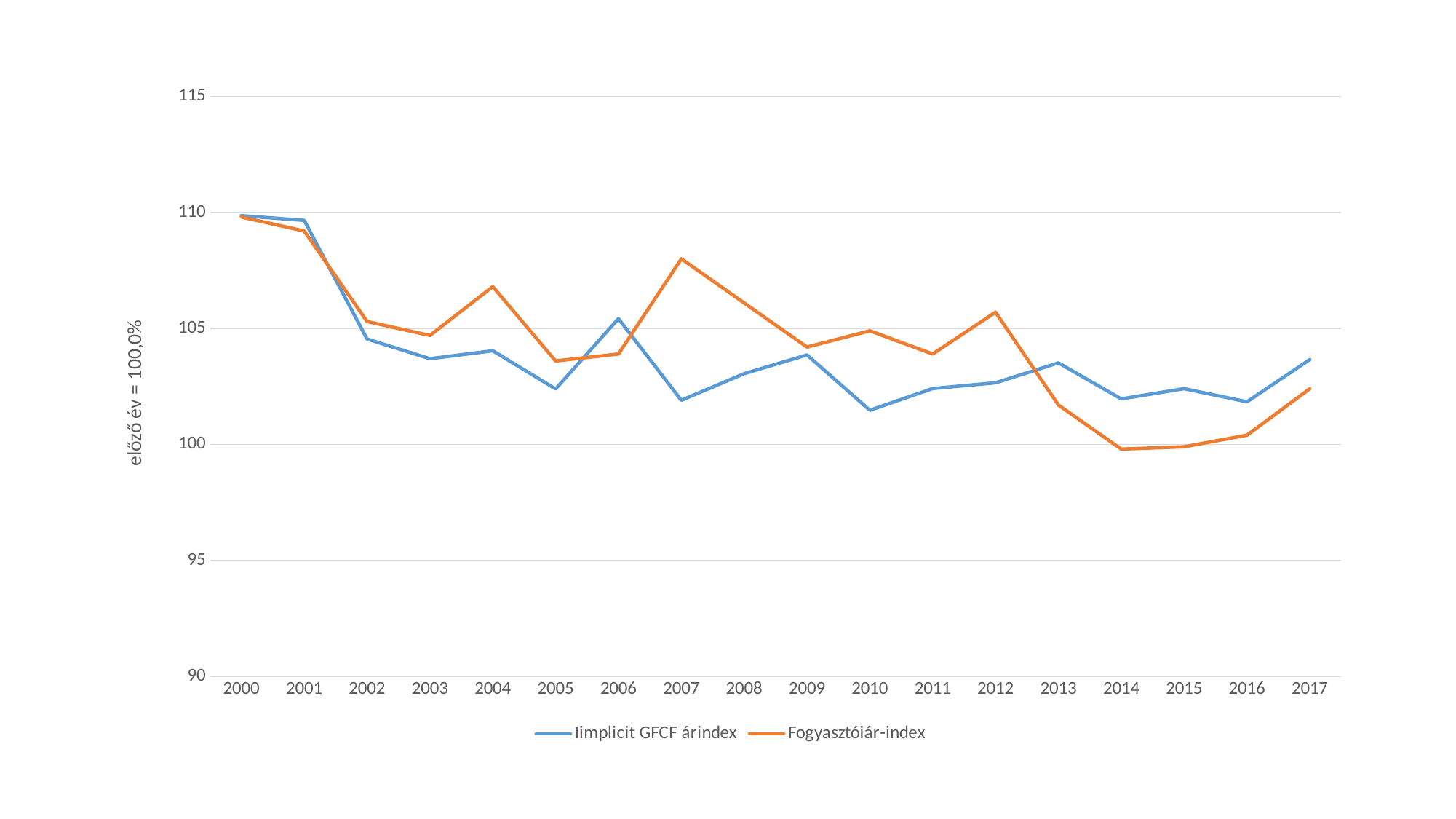
Is the value of Fogyasztóiár-index in 2014 greater or less than 100? less Is the value of Iimplicit GFCF árindex in 2010 greater or less than 100? greater Is the value of Fogyasztóiár-index in 2007 greater or less than 105? greater What kind of chart is shown on the slide? line chart How many series does the legend list? 2 Overall, do the values of Fogyasztóiár-index rise or fall from 2000 to 2017? fall How many years are shown on the x axis? 18 In 2013, which series has the higher value, Iimplicit GFCF árindex or Fogyasztóiár-index? Iimplicit GFCF árindex In 2007, which series has the higher value, Iimplicit GFCF árindex or Fogyasztóiár-index? Fogyasztóiár-index What is the label on the vertical axis? előző év = 100,0% In which year does the Fogyasztóiár-index series reach its highest value? 2000